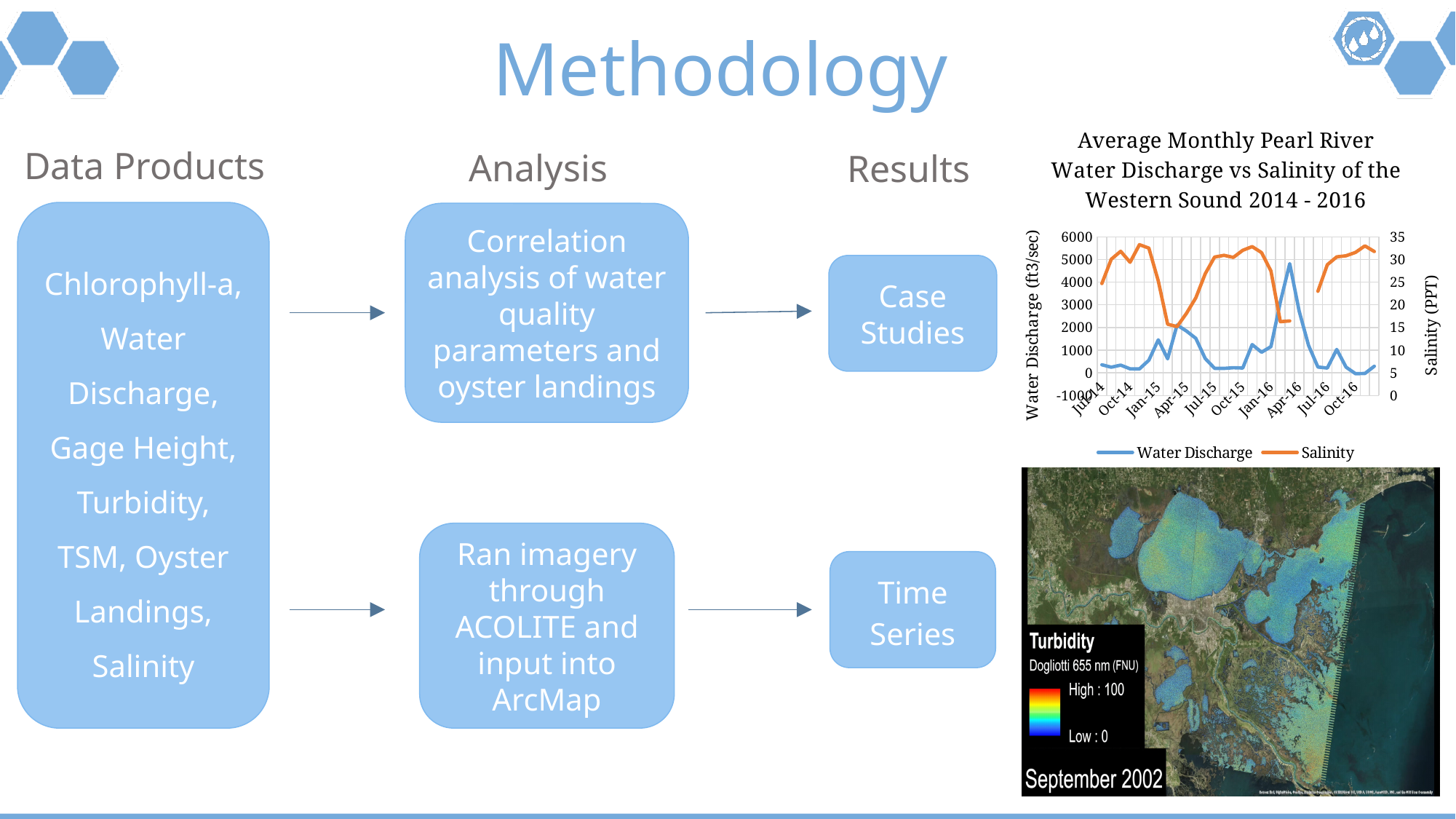
Does the Salinity series rise or fall between Jan-15 and Apr-15? fall Is the Water Discharge value at Jul-15 greater or less than 1000? less Is the Salinity value at Apr-15 greater or less than 20? less Is the Salinity value at Oct-15 greater or less than 25? greater Which colour is used for the Salinity series in the chart? orange How many labelled tick marks are on the chart's x axis? 10 Around which x-axis label does the Water Discharge series reach its highest value? Apr-16 Does the Water Discharge series rise or fall between Jan-16 and Apr-16? rise What is the title of the chart on the slide? Average Monthly Pearl River Water Discharge vs Salinity of the Western Sound 2014 - 2016 What kind of chart is shown on the slide? line chart How many series does the chart's legend list? 2